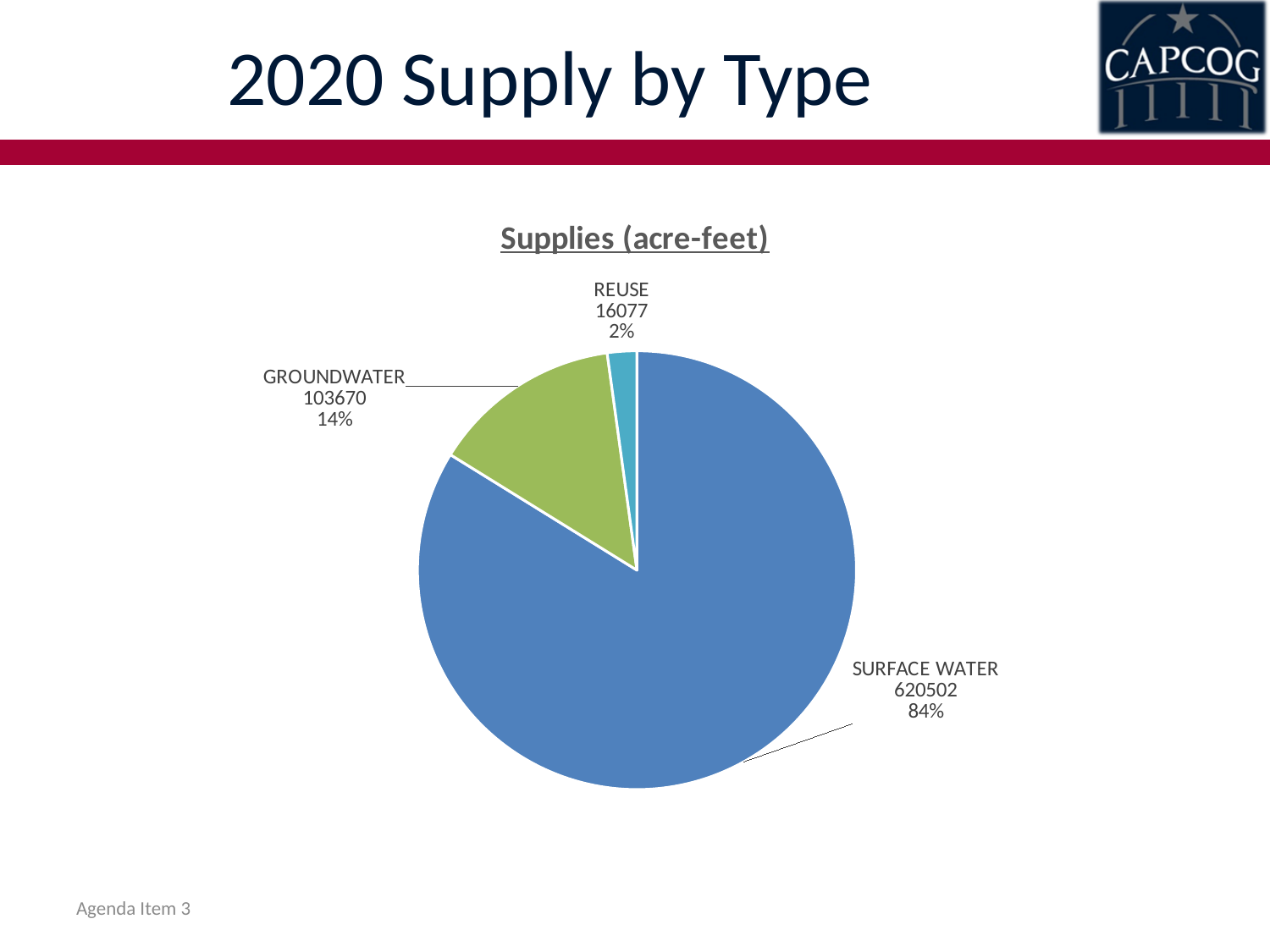
What type of chart is shown on the slide? pie chart Which supply type has the largest value? SURFACE WATER How many slices does the pie chart have? 3 What share of the pie does GROUNDWATER represent? 14% What is the value for REUSE? 16077 What is the title of the chart? Supplies (acre-feet) What is the value for GROUNDWATER? 103670 What share of the pie does SURFACE WATER represent? 84% What is the value for SURFACE WATER? 620502 Which supply type has the smallest value? REUSE What is the difference between the SURFACE WATER and GROUNDWATER values? 516832 What share of the pie does REUSE represent? 2%